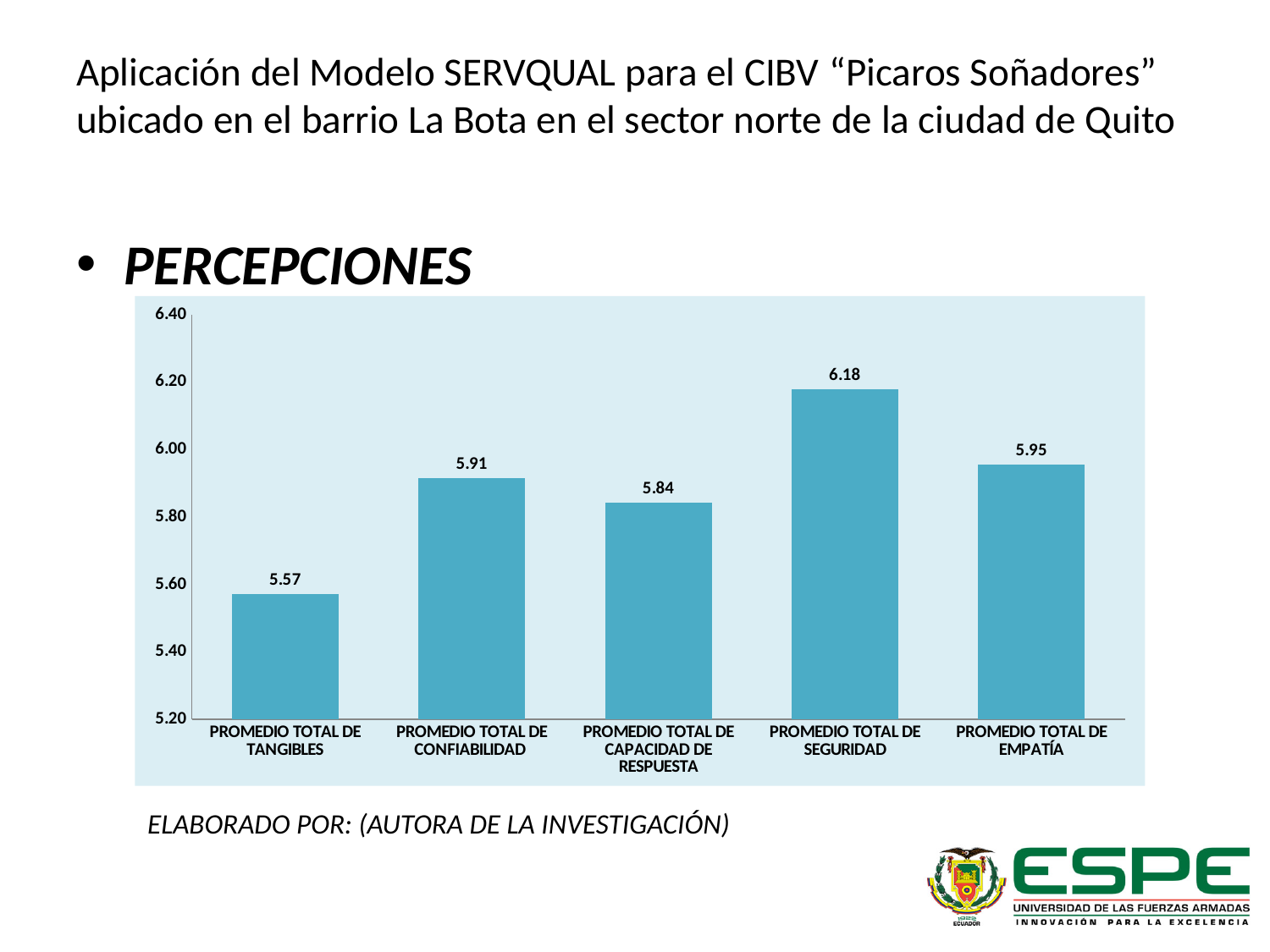
What is the value for PROMEDIO TOTAL DE TANGIBLES? 5.57 What is the value for PROMEDIO TOTAL DE CAPACIDAD DE RESPUESTA? 5.84 What is the difference between the values for PROMEDIO TOTAL DE SEGURIDAD and PROMEDIO TOTAL DE TANGIBLES? 0.61 Is the value for PROMEDIO TOTAL DE SEGURIDAD greater or less than 6.00? greater What is the value for PROMEDIO TOTAL DE SEGURIDAD? 6.18 What kind of chart is shown on the slide? bar chart How many categories are shown in the chart? 5 Which is larger, the value for PROMEDIO TOTAL DE CONFIABILIDAD or PROMEDIO TOTAL DE EMPATÍA? PROMEDIO TOTAL DE EMPATÍA What is the value for PROMEDIO TOTAL DE CONFIABILIDAD? 5.91 Which category has the lowest value? PROMEDIO TOTAL DE TANGIBLES What is the value for PROMEDIO TOTAL DE EMPATÍA? 5.95 Which category has the highest value? PROMEDIO TOTAL DE SEGURIDAD